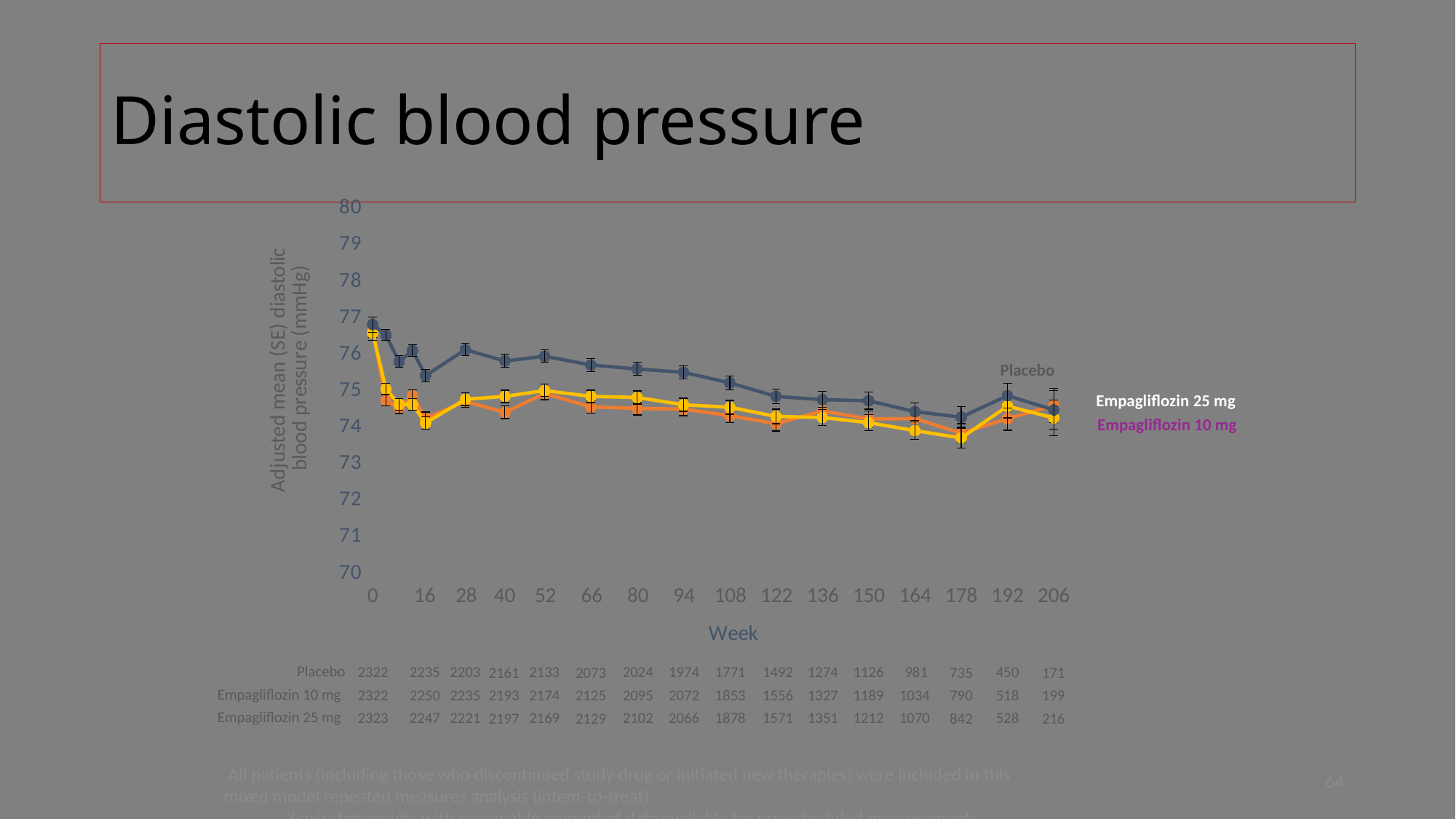
Is the Placebo value at week 94 greater or less than 75? greater What is the title of the y axis of the chart? Adjusted mean (SE) diastolic blood pressure (mmHg) What kind of chart is shown on the slide? line chart According to the patient-number table below the chart, how many Placebo patients are listed at week 0? 2322 At week 80, which is larger: the Placebo value or the Empagliflozin 25 mg value? Placebo According to the patient-number table below the chart, how many Empagliflozin 25 mg patients are listed at week 206? 216 Is the Placebo value at week 0 greater or less than 76? greater Does the Placebo line generally rise or fall from week 0 to week 178? fall How many series are plotted in the chart? 3 What is the title of the x axis of the chart? Week Which series has the highest value at week 108? Placebo Is the Empagliflozin 25 mg value at week 178 greater or less than 74? less